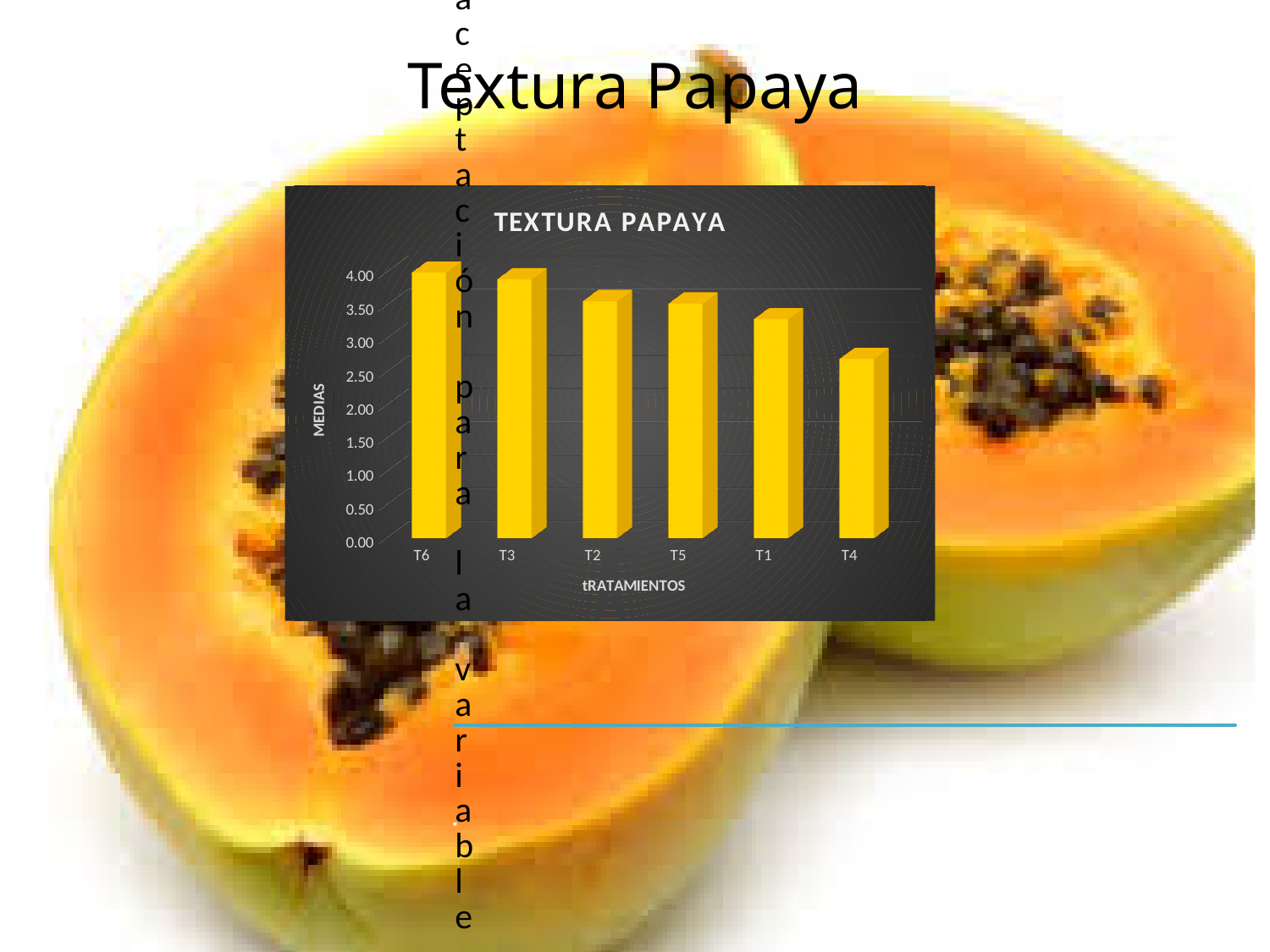
Which is larger, the value for T1 or the value for T4? T1 What is the title of the vertical axis in the chart? MEDIAS Is the value for T4 greater or less than 2.50? greater Is the value for T1 greater or less than 3.00? greater Is the value for T6 greater or less than 3.50? greater What kind of chart is shown on the slide? bar chart What is the title of the horizontal axis in the chart? tRATAMIENTOS Do the bar values rise or fall from left to right across the x axis? fall How many treatments (categories) are plotted in the TEXTURA PAPAYA chart? 6 Which treatment has the lowest value in the TEXTURA PAPAYA chart? T4 Which is larger, the value for T3 or the value for T1? T3